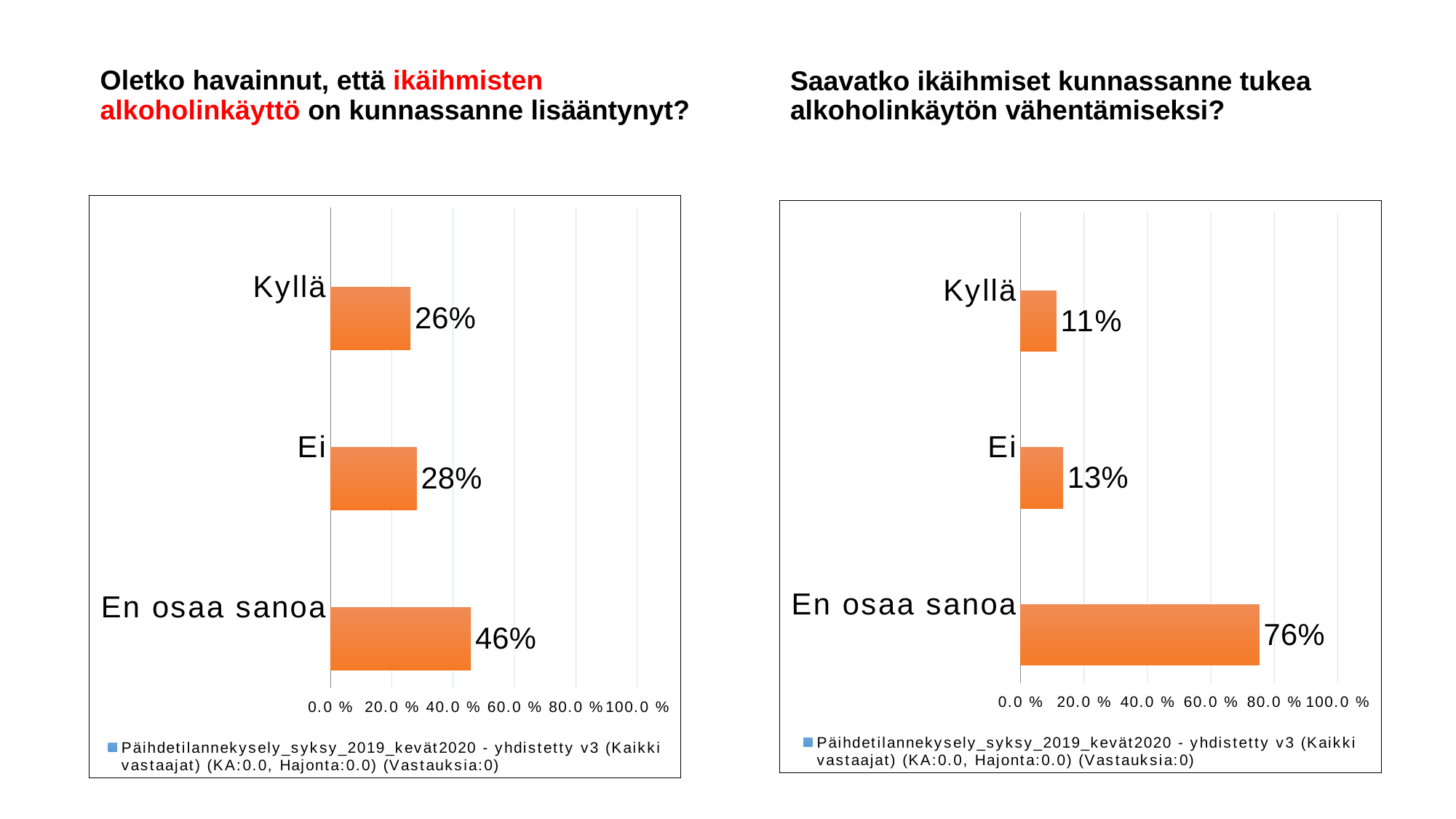
In the right chart, what is the difference between the values for En osaa sanoa and Kyllä? 65% In the right chart (Saavatko ikäihmiset kunnassanne tukea alkoholinkäytön vähentämiseksi?), what is the value for Ei? 13% How many series does the legend of the left chart list? 1 In the right chart (Saavatko ikäihmiset kunnassanne tukea alkoholinkäytön vähentämiseksi?), what is the value for En osaa sanoa? 76% In the right chart, which category has the lowest value? Kyllä How many categories are shown in the left chart? 3 In the left chart (Oletko havainnut, että ikäihmisten alkoholinkäyttö on kunnassanne lisääntynyt?), what is the value for En osaa sanoa? 46% In the left chart, what is the difference between the values for Ei and Kyllä? 2% In the left chart (Oletko havainnut, että ikäihmisten alkoholinkäyttö on kunnassanne lisääntynyt?), what is the value for Kyllä? 26% In the right chart, which is larger, the value for Kyllä or the value for Ei? Ei In the left chart, which category has the highest value? En osaa sanoa What kind of chart is the right chart? Bar chart